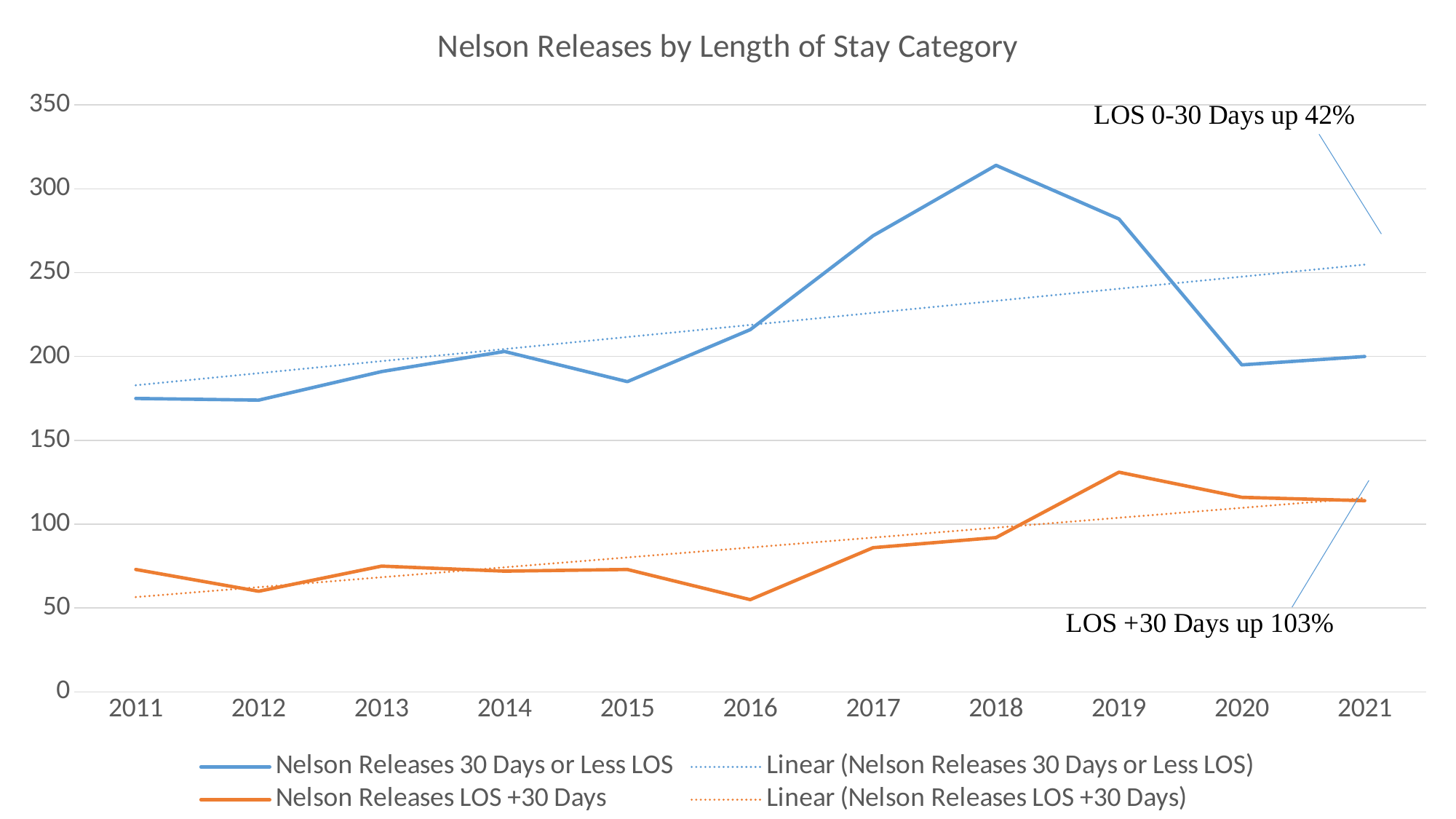
In which year does the Nelson Releases 30 Days or Less LOS series reach its highest value? 2018 Is the value for Nelson Releases LOS +30 Days in 2016 greater or less than 100? less What is the title of the chart? Nelson Releases by Length of Stay Category Is the value for Nelson Releases 30 Days or Less LOS in 2018 greater or less than 300? greater How many years are plotted along the x axis? 11 How many entries does the legend list? 4 In 2018, which series has the larger value: Nelson Releases 30 Days or Less LOS or Nelson Releases LOS +30 Days? Nelson Releases 30 Days or Less LOS What kind of chart is shown on the slide? line chart Is the value for Nelson Releases 30 Days or Less LOS in 2020 greater or less than 250? less Does the Nelson Releases LOS +30 Days series rise or fall from 2016 to 2019? rise In which year does the Nelson Releases LOS +30 Days series reach its highest value? 2019 In which year does the Nelson Releases LOS +30 Days series reach its lowest value? 2016